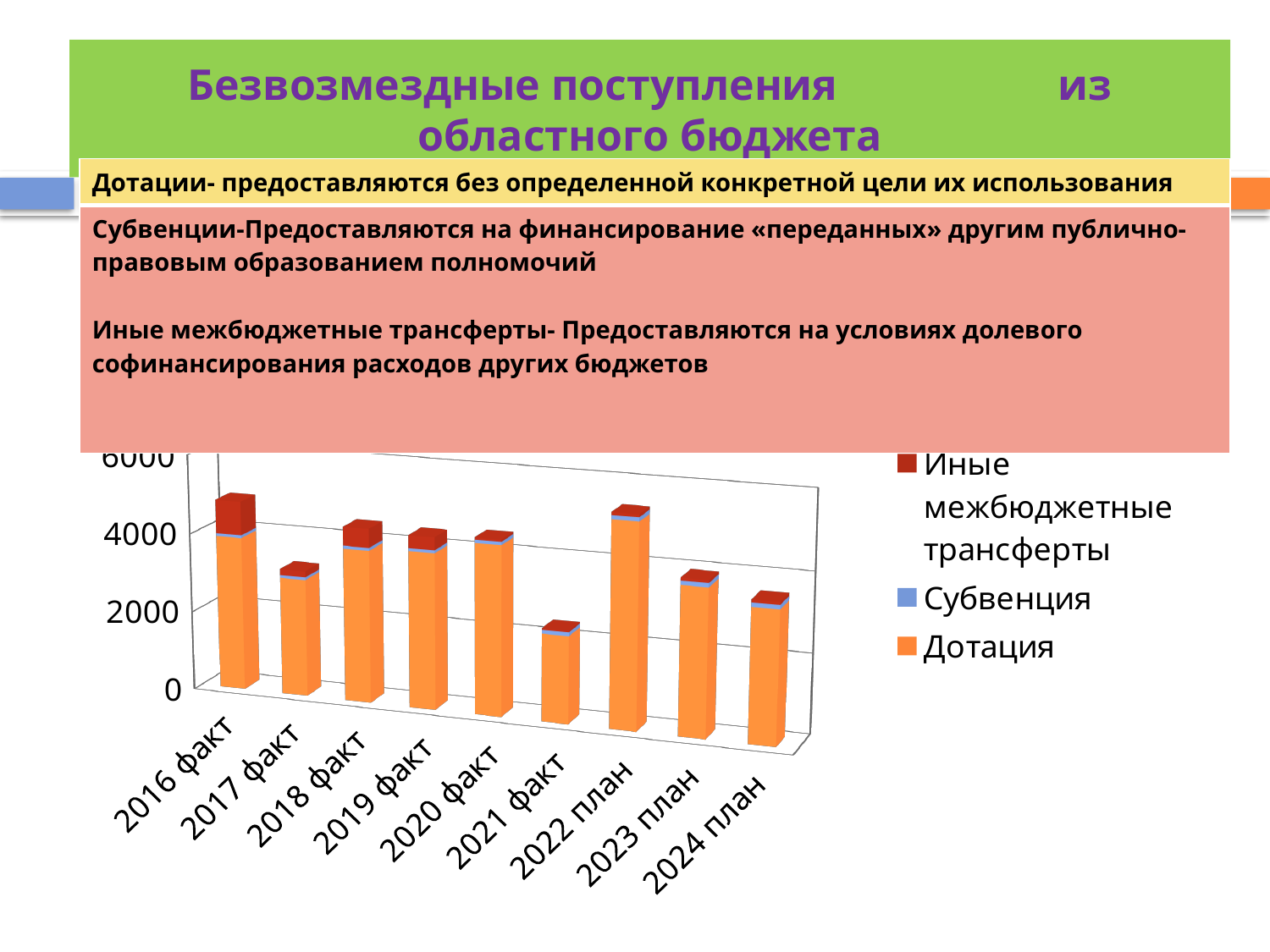
How many series does the chart legend list? 3 Which category has the lowest total bar in the chart? 2021 факт What kind of chart is shown on the slide? Stacked bar chart How many categories are shown on the x axis of the chart? 9 Which has the larger total bar, 2021 факт or 2022 план? 2022 план Which series is shown in orange in the chart legend? Дотация Which has the larger total bar, 2017 факт or 2018 факт? 2018 факт Is the total value for 2016 факт greater or less than 4000? greater Is the total value for 2022 план greater or less than 4000? greater Is the total value for 2017 факт greater or less than 4000? less Do the total values rise or fall from 2022 план to 2024 план? fall